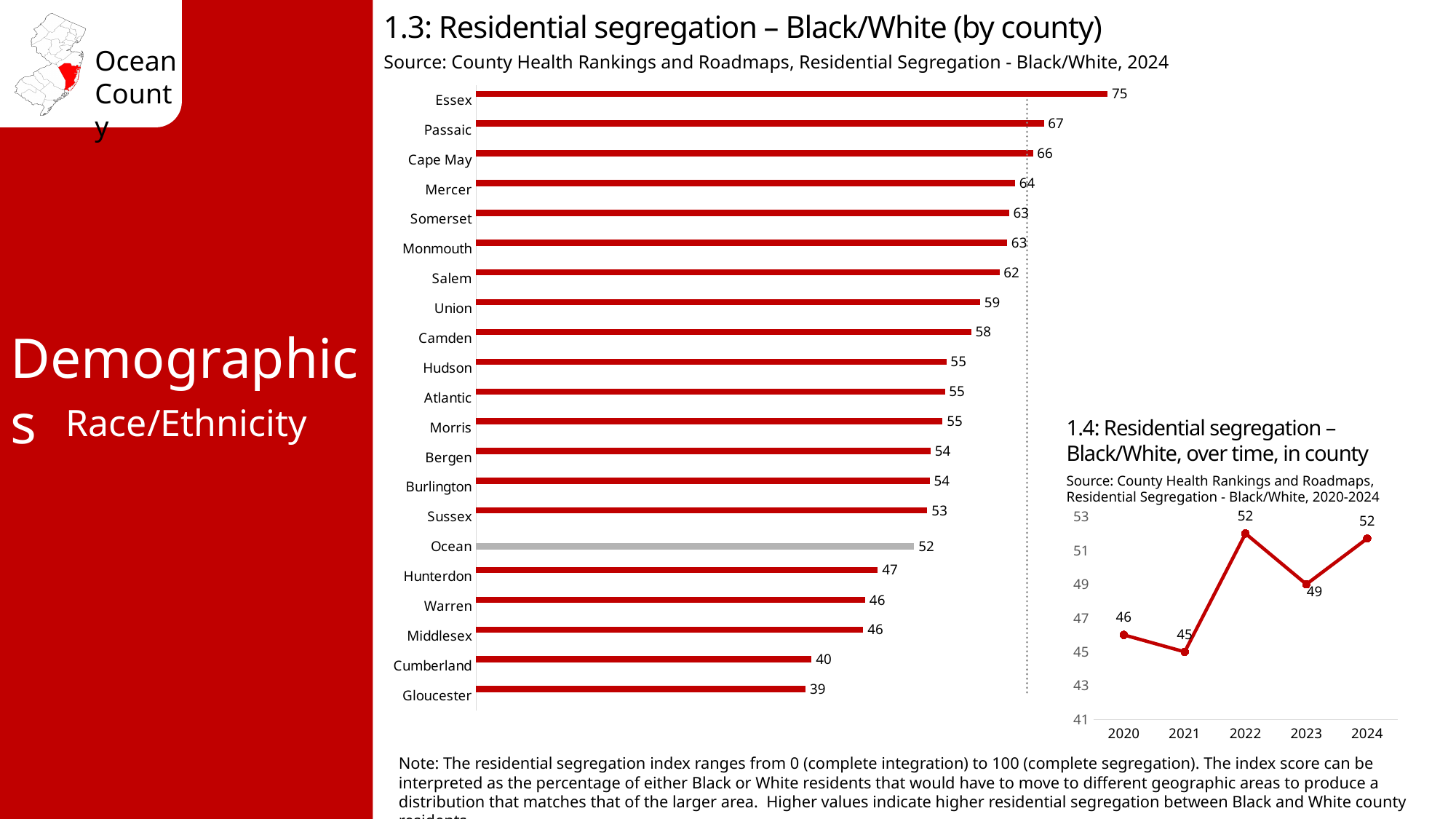
In chart 1.3 (by county), which county has the highest residential segregation index? Essex In chart 1.3 (by county), what is the difference between the values for Essex and Ocean? 23 In chart 1.3 (by county), which county has the lowest residential segregation index? Gloucester In chart 1.3 (by county), what is the value for Cumberland? 40 In chart 1.3 (Residential segregation – Black/White by county), what is the value for Ocean? 52 What kind of chart is chart 1.3 (Residential segregation – Black/White by county)? Bar chart In chart 1.4 (Residential segregation over time, in county), what is the value for 2021? 45 What kind of chart is chart 1.4 (Residential segregation over time, in county)? Line chart In chart 1.3 (by county), which has a higher value, Passaic or Camden? Passaic In chart 1.3 (by county), how many counties are shown? 21 In chart 1.4 (over time), what is the difference between the values for 2022 and 2023? 3 In chart 1.4 (over time), which year has the lowest value? 2021